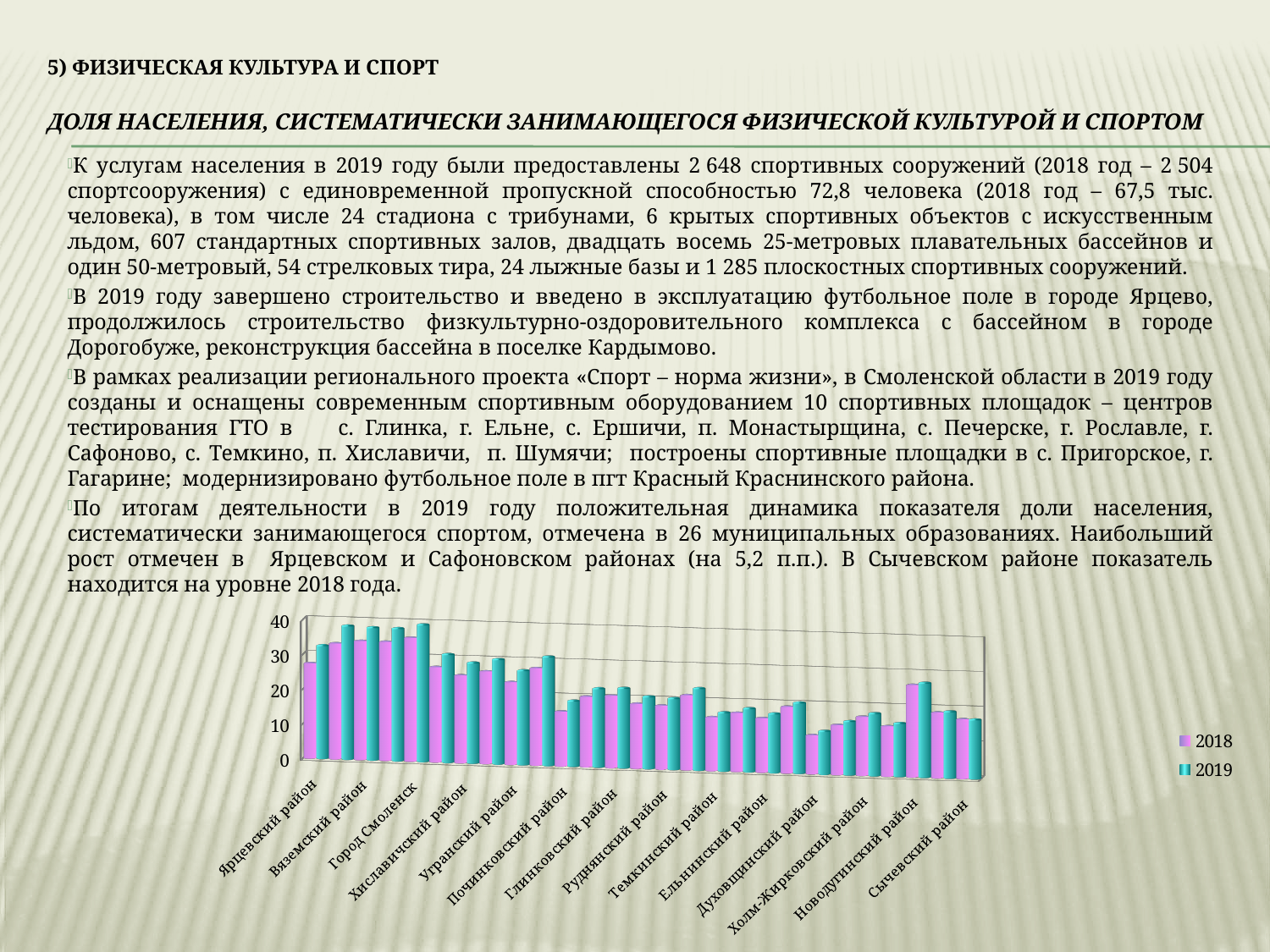
What kind of chart is shown on the slide? bar chart For Ярцевский район, which is larger: the 2018 value or the 2019 value? 2019 Which years are listed in the chart legend? 2018 and 2019 Is the 2018 value for Сычевский район greater or less than 20? less Which colour represents the 2019 series in the chart? teal Is the 2019 value for Сычевский район greater or less than 20? less How many series does the chart legend list? 2 Do the values generally rise or fall moving from left to right along the x axis? fall Is the 2019 value for Ярцевский район greater or less than 30? greater What is the highest value shown on the chart's vertical axis? 40